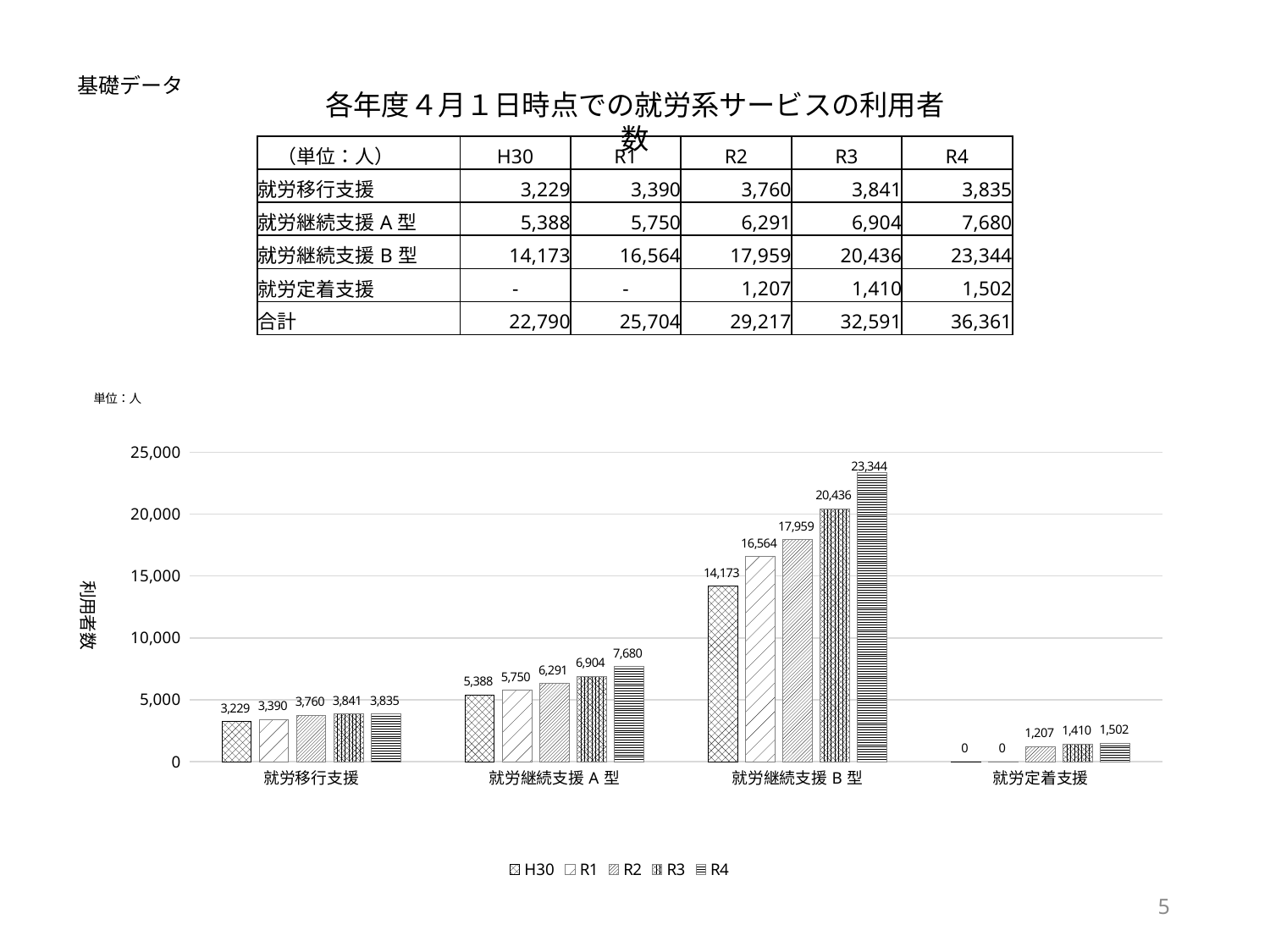
What is the difference between the R4 and H30 values for 就労継続支援Ｂ型? 9,171 Which is larger for 就労継続支援Ａ型: the R1 value or the R2 value? R2 How many categories are shown on the x axis of the chart? 4 What kind of chart is shown on the slide? bar chart What is the value for 就労継続支援Ｂ型 in the R4 series? 23,344 Do the values for 就労継続支援Ｂ型 rise or fall from H30 to R4? rise Is the R2 value for 就労継続支援Ｂ型 greater or less than 15,000? greater Which category has the lowest value in the R4 series? 就労定着支援 How many series does the legend list? 5 What is the value for 就労移行支援 in the H30 series? 3,229 What is the value for 就労定着支援 in the R2 series? 1,207 Which category has the highest value in the R3 series? 就労継続支援Ｂ型